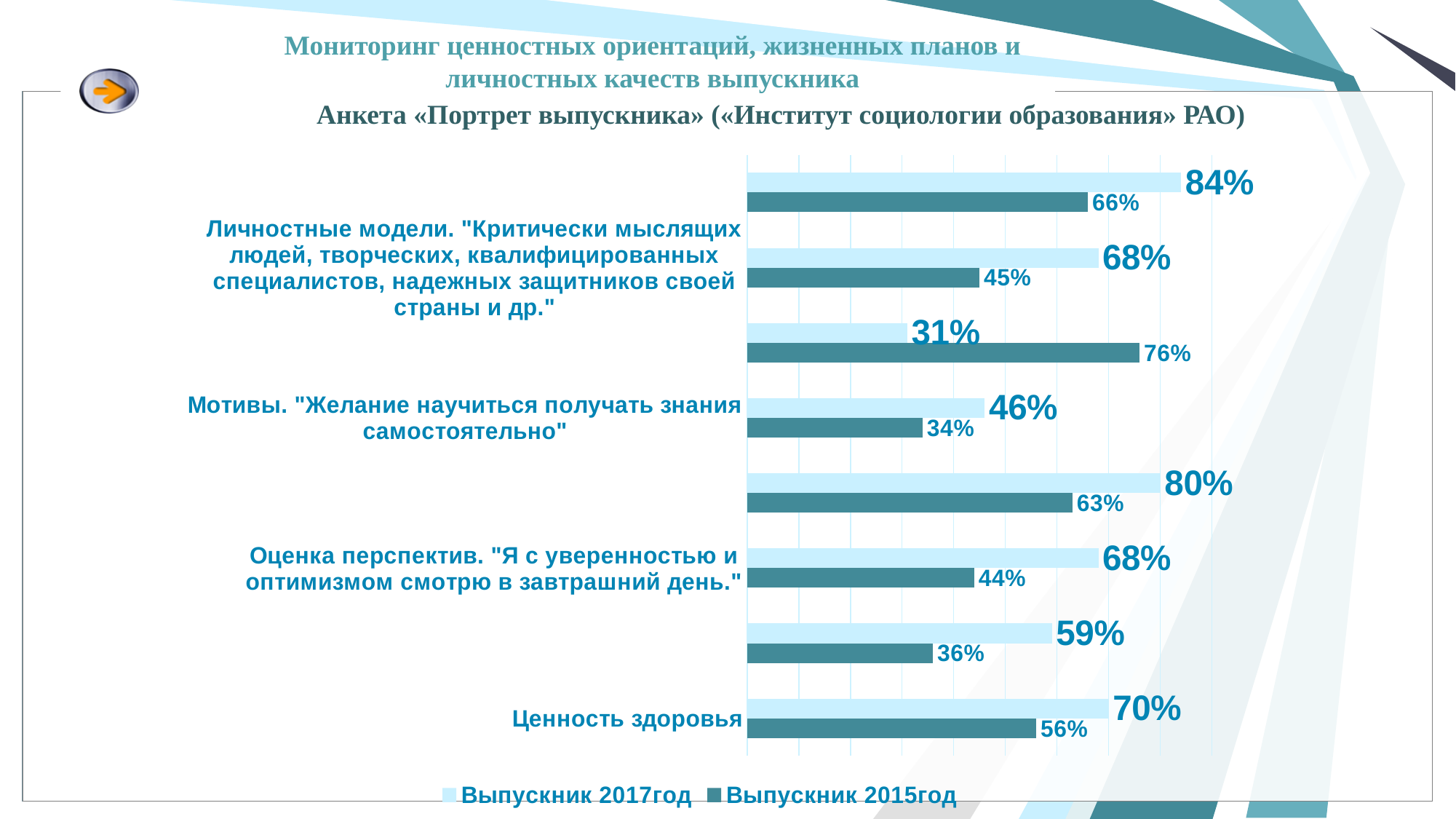
What is the lowest value shown for the Выпускник 2015год series? 34% What is the value for "Ценность здоровья" for Выпускник 2015год? 56% How many series does the legend list? 2 What is the difference between the 2017 and 2015 values for "Ценность здоровья"? 14 percentage points What kind of chart is shown on the slide? Bar chart What is the value for "Ценность здоровья" for Выпускник 2017год? 70% What is the value for Выпускник 2017год in the category "Мотивы. Желание научиться получать знания самостоятельно"? 46% By how many percentage points does Выпускник 2017год exceed Выпускник 2015год in the category "Оценка перспектив"? 24 percentage points What is the value for Выпускник 2015год in the category "Личностные модели"? 45% What is the value for Выпускник 2015год in the category "Оценка перспектив. Я с уверенностью и оптимизмом смотрю в завтрашний день"? 44% What is the highest value shown for the Выпускник 2017год series? 84% In the category "Мотивы", which series has the larger value, Выпускник 2017год or Выпускник 2015год? Выпускник 2017год